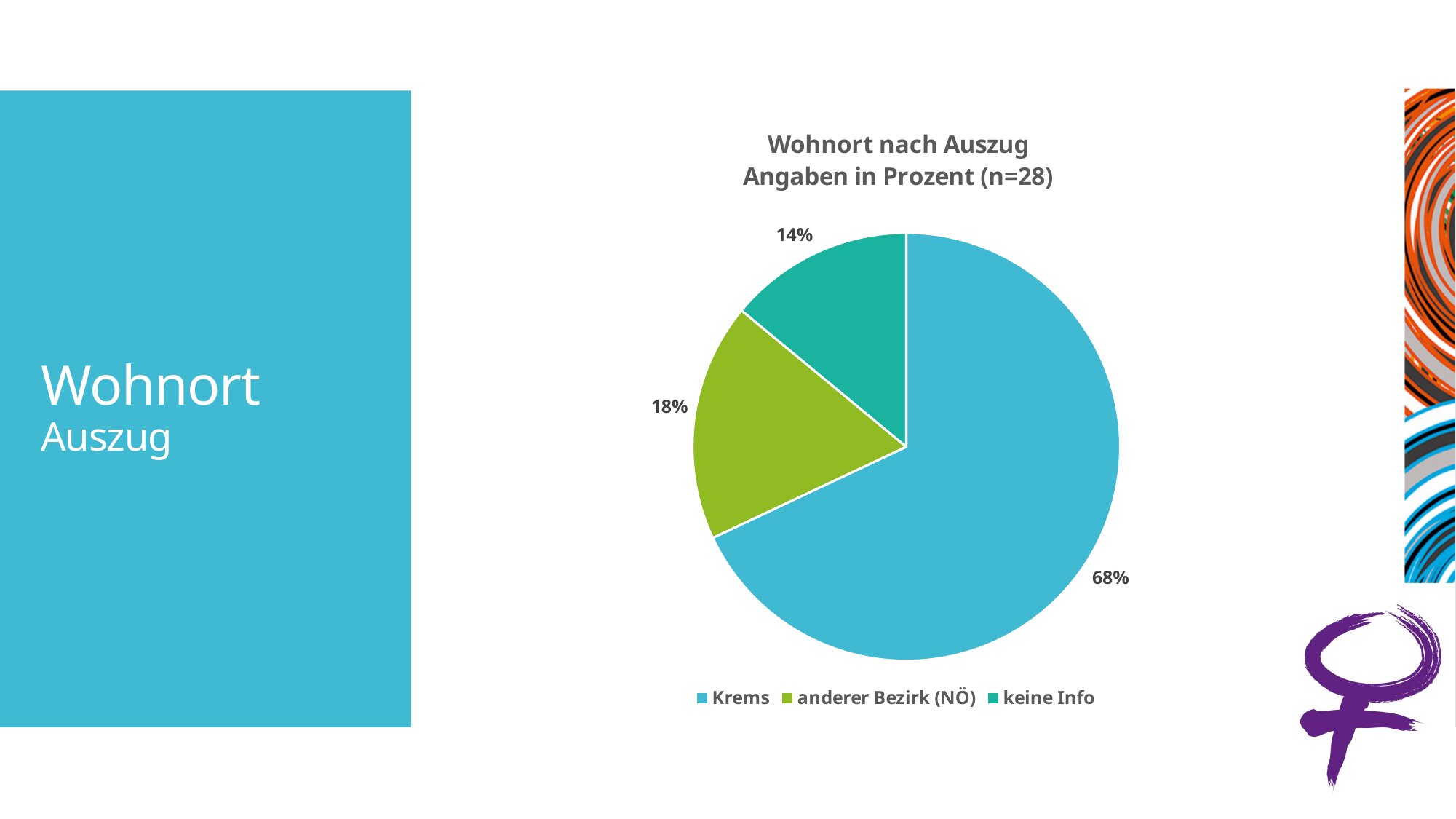
What percentage of the pie chart is for Krems? 68% What is the sample size (n) stated in the chart title? 28 What is the title of the chart? Wohnort nach Auszug Angaben in Prozent (n=28) How many categories does the pie chart show? 3 Which category has the largest slice of the pie chart? Krems What is the difference in percentage points between Krems and anderer Bezirk (NÖ)? 50 What percentage of the pie chart is for keine Info? 14% Which category has the smallest slice of the pie chart? keine Info Which is larger, the slice for anderer Bezirk (NÖ) or the slice for keine Info? anderer Bezirk (NÖ) What is the difference in percentage points between anderer Bezirk (NÖ) and keine Info? 4 What kind of chart is shown on the slide? pie chart What percentage of the pie chart is for anderer Bezirk (NÖ)? 18%